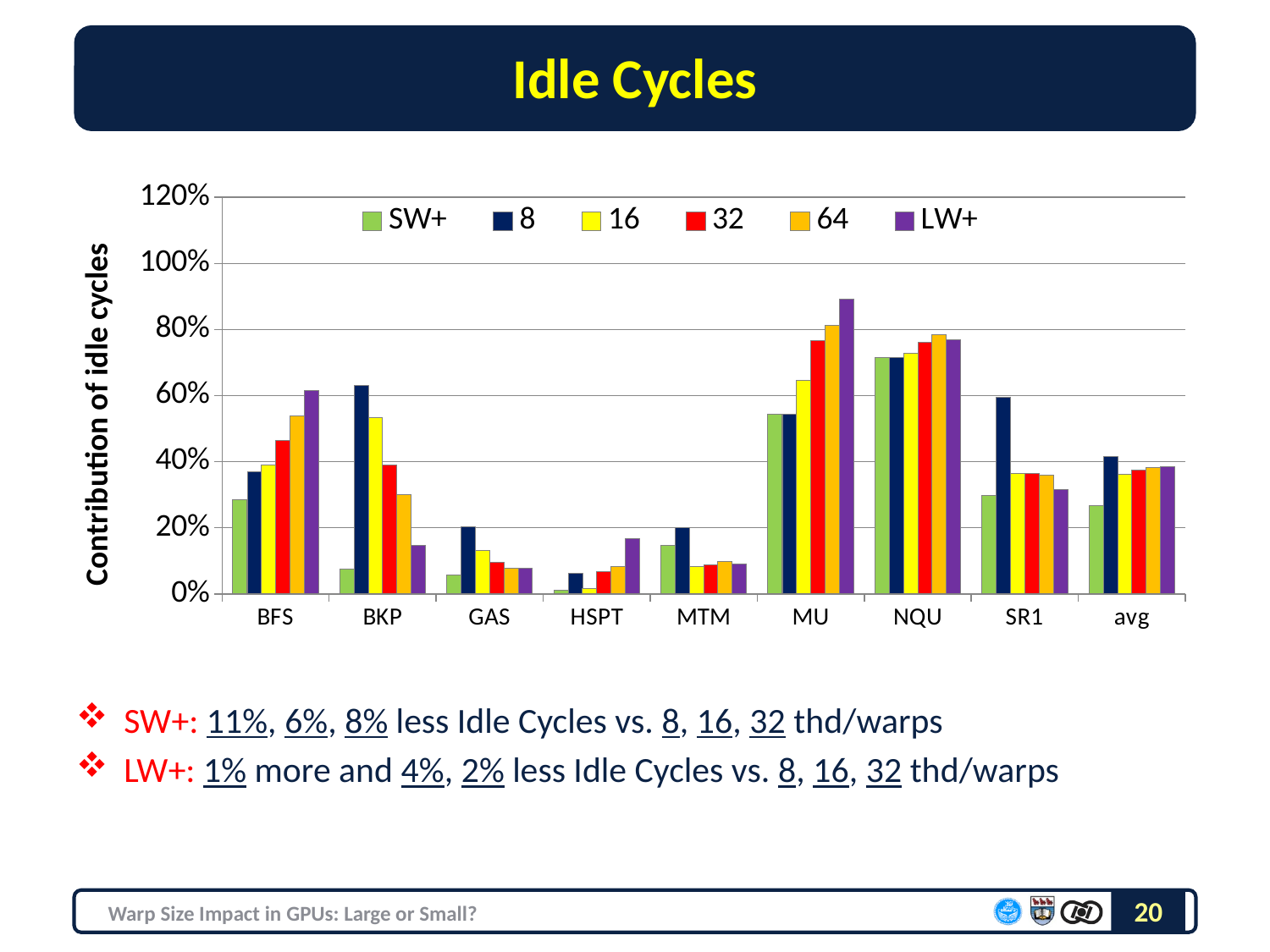
What is the title of the y axis? Contribution of idle cycles How many categories are shown along the x axis? 9 Is the value of series 8 for BKP greater or less than 60%? greater What kind of chart is shown on the slide? bar chart How many series does the legend list? 6 Which category has the highest LW+ bar? MU Is the LW+ value for MU greater or less than 80%? greater For BFS, do the bars rise or fall going from SW+ to LW+? rise Is the SW+ value for avg greater or less than 40%? less For BFS, which is larger: the SW+ bar or the LW+ bar? LW+ For BKP, which is larger: the bar for 8 or the bar for LW+? 8 Which category has the lowest SW+ bar? HSPT